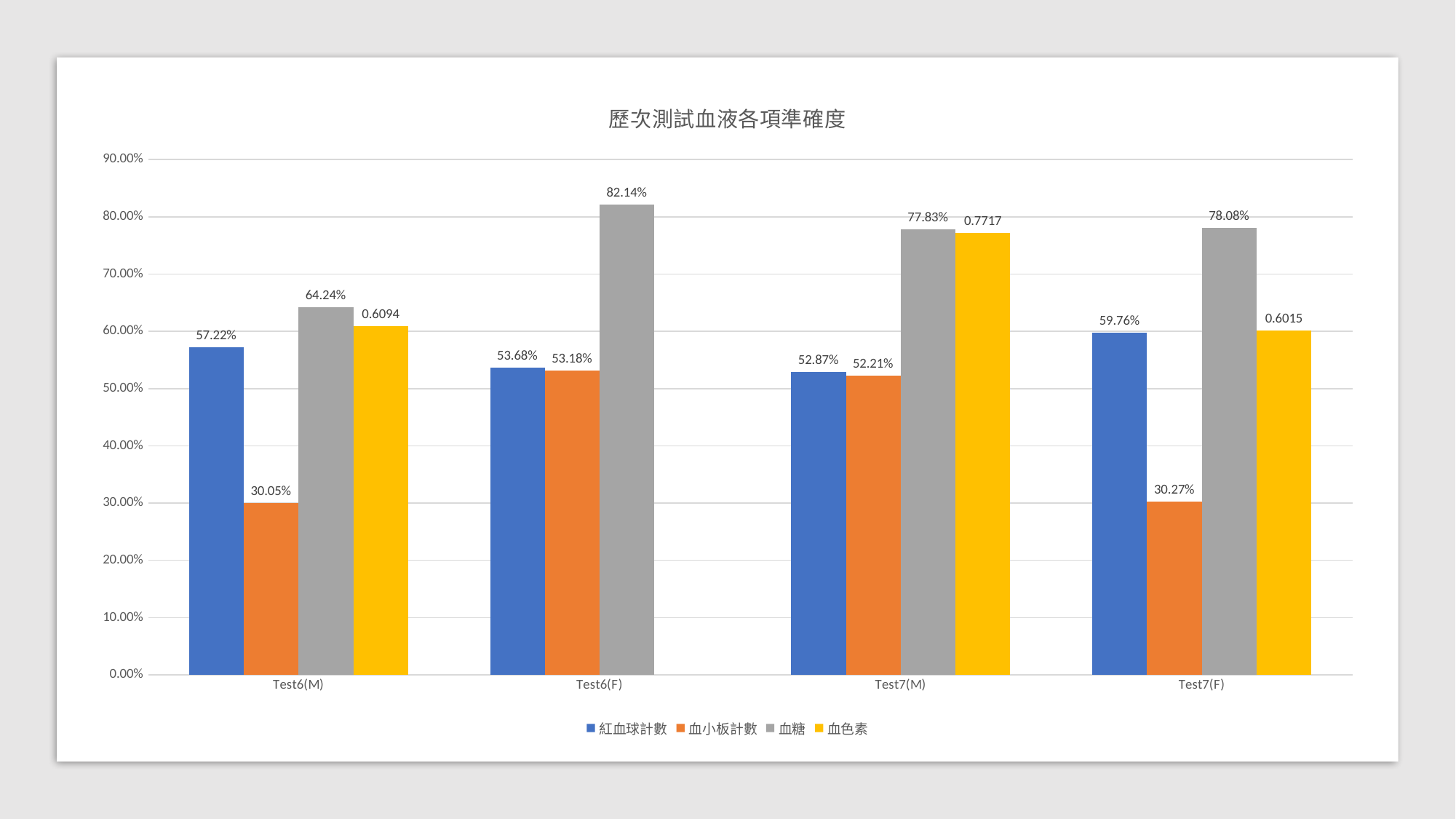
How many categories are shown on the x axis? 4 Which category has the lowest 血小板計數 value? Test6(M) What is the title of the chart? 歷次測試血液各項準確度 What is the difference between the 血糖 value and the 紅血球計數 value for Test7(F)? 18.32% What is the value of 血小板計數 for Test7(F)? 30.27% What is the value of 血糖 for Test6(F)? 82.14% Which is larger for Test6(M): 紅血球計數 or 血糖? 血糖 Which category has the highest 血糖 value? Test6(F) What kind of chart is shown on the slide? Bar chart How many series does the legend list? 4 What is the data label shown for 血色素 at Test7(M)? 0.7717 What is the value of 紅血球計數 for Test6(M)? 57.22%